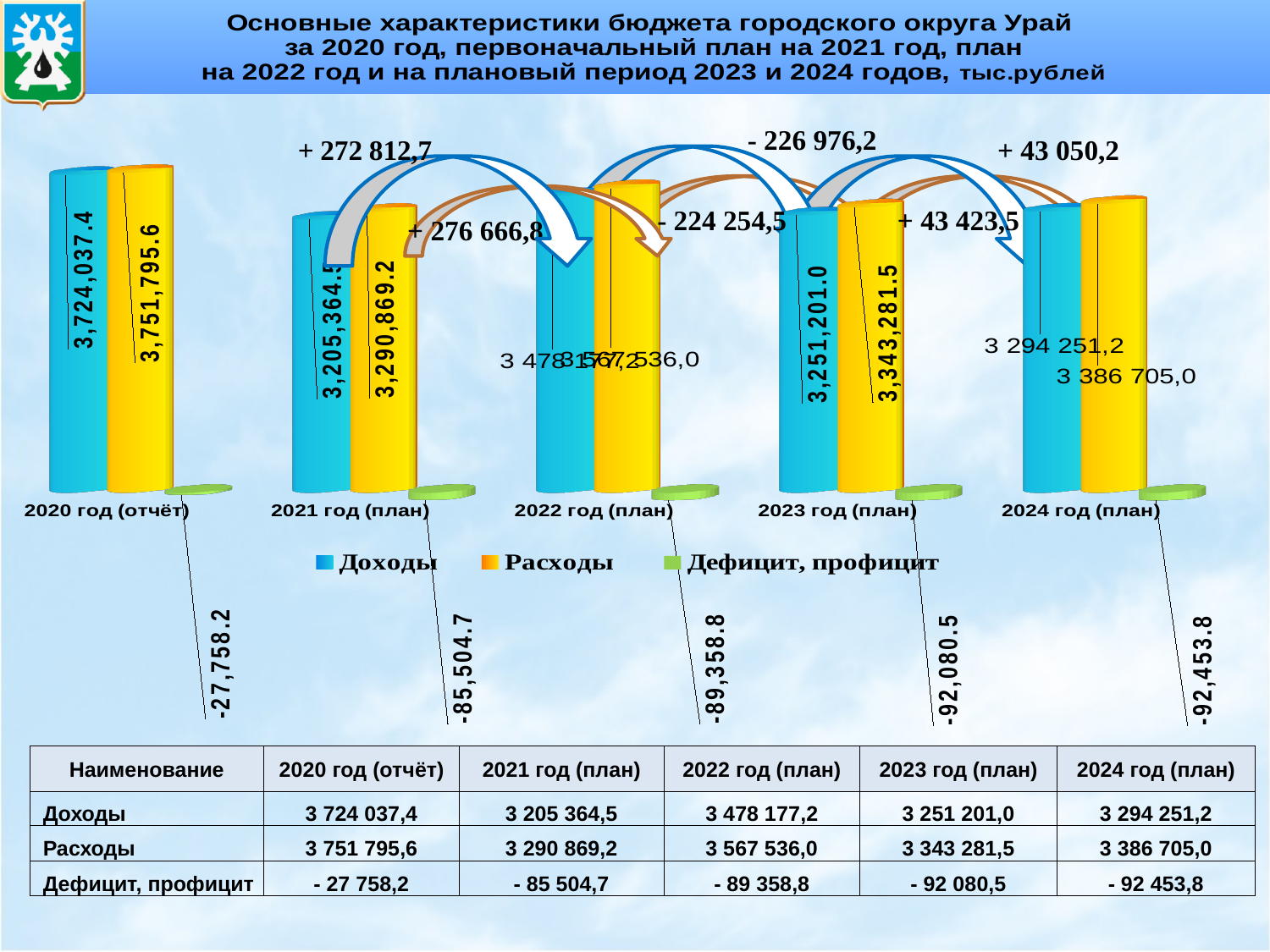
Which year has the highest value of Доходы? 2020 год (отчёт) What is the change in Доходы from 2021 год (план) to 2022 год (план), as labelled on the arrow? + 272 812,7 Which series is shown in green in the legend? Дефицит, профицит What kind of chart is shown on the slide? bar chart Which is larger for 2023 год (план): Доходы or Расходы? Расходы How many year categories are shown on the chart's x axis? 5 What is the value of Расходы for 2024 год (план)? 3 386 705,0 What is the value of Доходы for 2020 год (отчёт)? 3,724,037.4 Which year has the lowest value of Доходы? 2021 год (план) What is the value of Дефицит, профицит for 2023 год (план)? -92,080.5 What is the value of Расходы for 2021 год (план)? 3,290,869.2 How many series does the chart legend list? 3